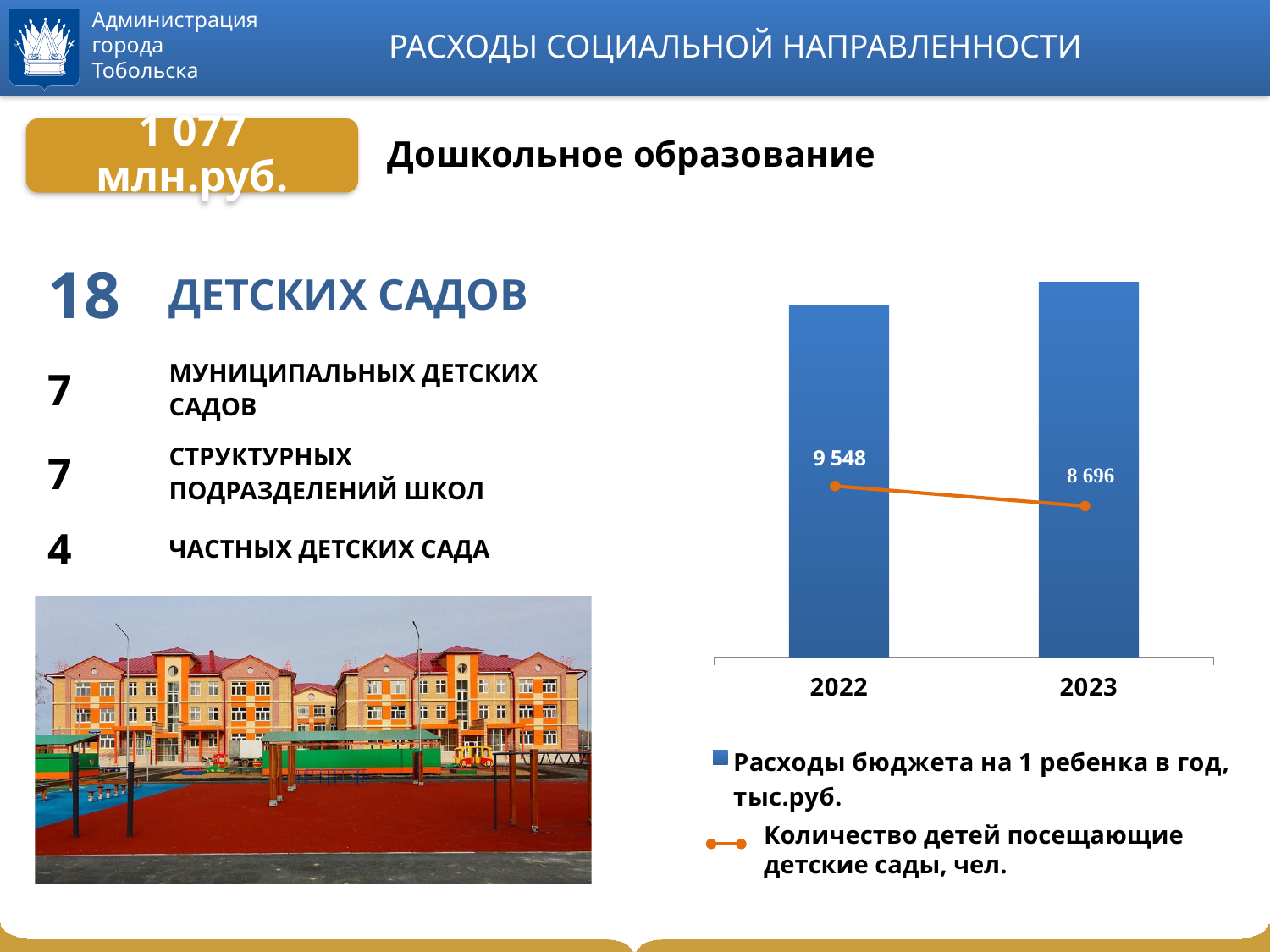
Which year has the lower number of children attending kindergartens? 2023 Does the number of children attending kindergartens rise or fall from 2022 to 2023? fall Do the budget expenses per child rise or fall from 2022 to 2023? rise Which series is shown as bars in the chart? Расходы бюджета на 1 ребенка в год, тыс.руб. How many series does the chart legend list? 2 What is the number of children attending kindergartens in 2022? 9 548 By how much did the number of children attending kindergartens decrease from 2022 to 2023? 852 What is the number of children attending kindergartens in 2023? 8 696 What kind of chart is shown on the slide? Combined bar and line chart Which year has the taller bar for budget expenses per child? 2023 Which year has the higher number of children attending kindergartens? 2022 How many years are shown on the x axis of the chart? 2